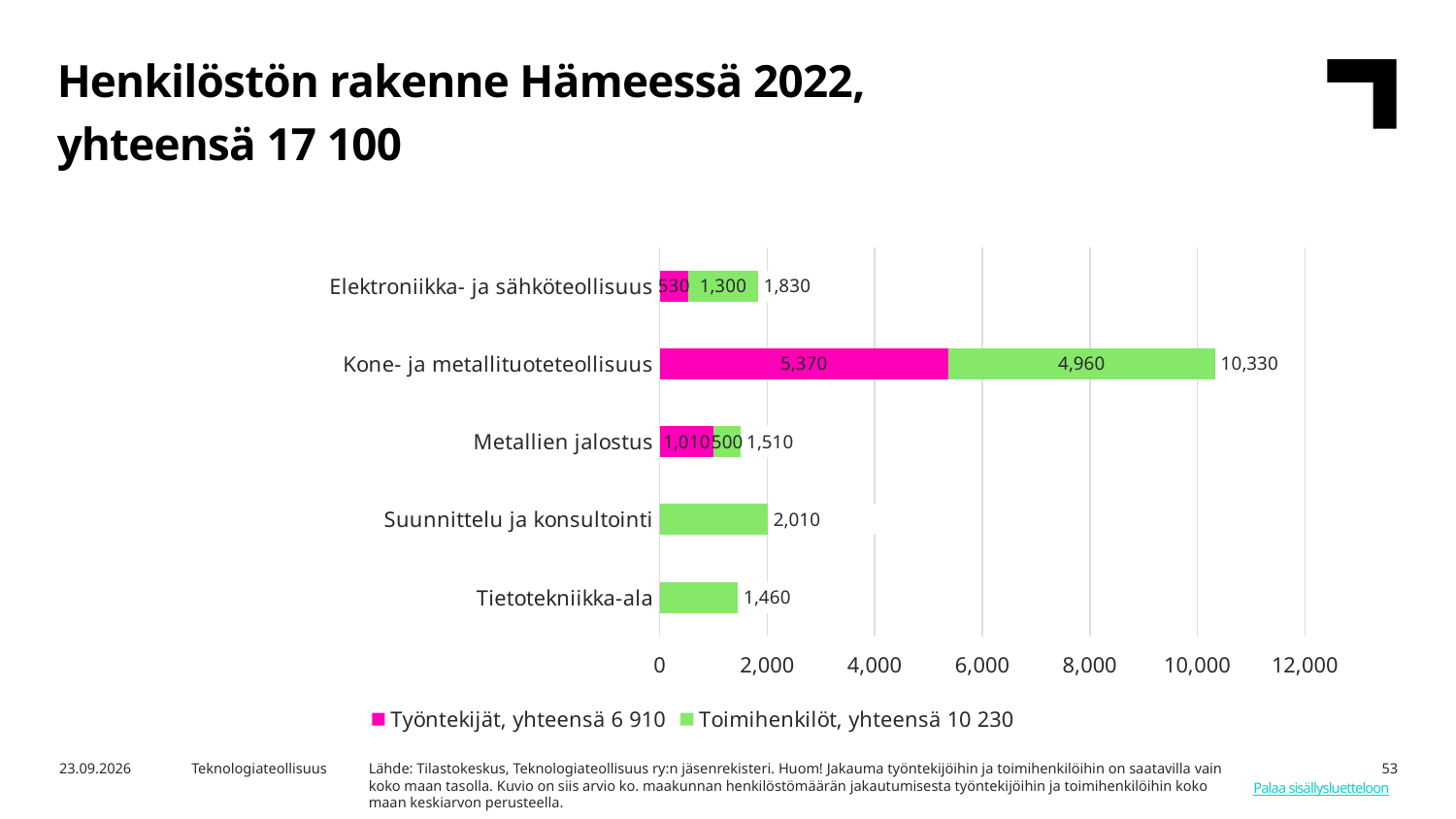
Is the total for Kone- ja metallituoteteollisuus greater or less than 10,000? greater How many series does the legend list? 2 What kind of chart is shown on the slide? Stacked bar chart What is the total given in the legend for Toimihenkilöt? 10 230 What is the Työntekijät value for Kone- ja metallituoteteollisuus? 5,370 What is the difference between the Työntekijät and Toimihenkilöt values for Kone- ja metallituoteteollisuus? 410 What is the total shown for Metallien jalostus? 1,510 How many categories are shown in the chart? 5 What is the Toimihenkilöt value for Elektroniikka- ja sähköteollisuus? 1,300 Which is larger: the total for Suunnittelu ja konsultointi or the total for Elektroniikka- ja sähköteollisuus? Suunnittelu ja konsultointi Which category has the highest total? Kone- ja metallituoteteollisuus Which category has the lowest total? Tietotekniikka-ala